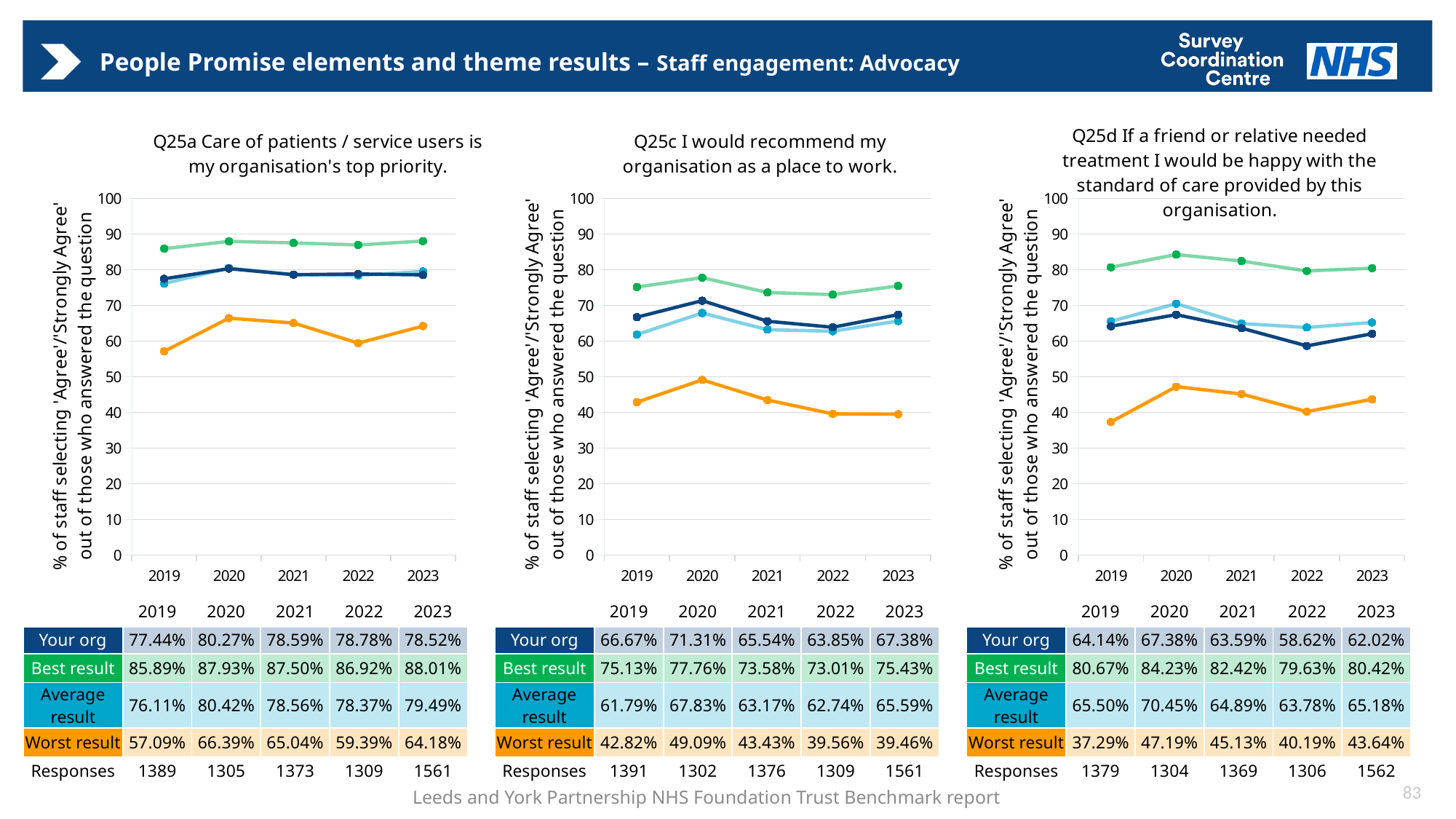
In the Q25c chart (middle), does the 'Worst result' line rise or fall from 2020 to 2023? Fall How many lines (series) are plotted in the Q25c chart (middle)? 4 In the Q25a chart (left), what is the 'Your org' value for 2023? 78.52% In the Q25c chart (middle), in which year is the 'Your org' value lowest? 2022 In the Q25d chart (right), what is the 'Average result' value for 2020? 70.45% In the Q25a chart (left), what is the difference between the 'Best result' and 'Your org' values in 2023? 9.49 percentage points What type of chart is used for Q25d (right)? Line chart In the Q25c chart (middle), what is the 'Worst result' value for 2022? 39.56% In the Q25c chart (middle), is the 'Worst result' value for 2019 greater or less than 50? less In the Q25d chart (right), which is larger in 2020: 'Your org' or 'Average result'? Average result How many years are shown on the x axis of the Q25a chart (left)? 5 In the Q25d chart (right), in which year is the 'Best result' highest? 2020